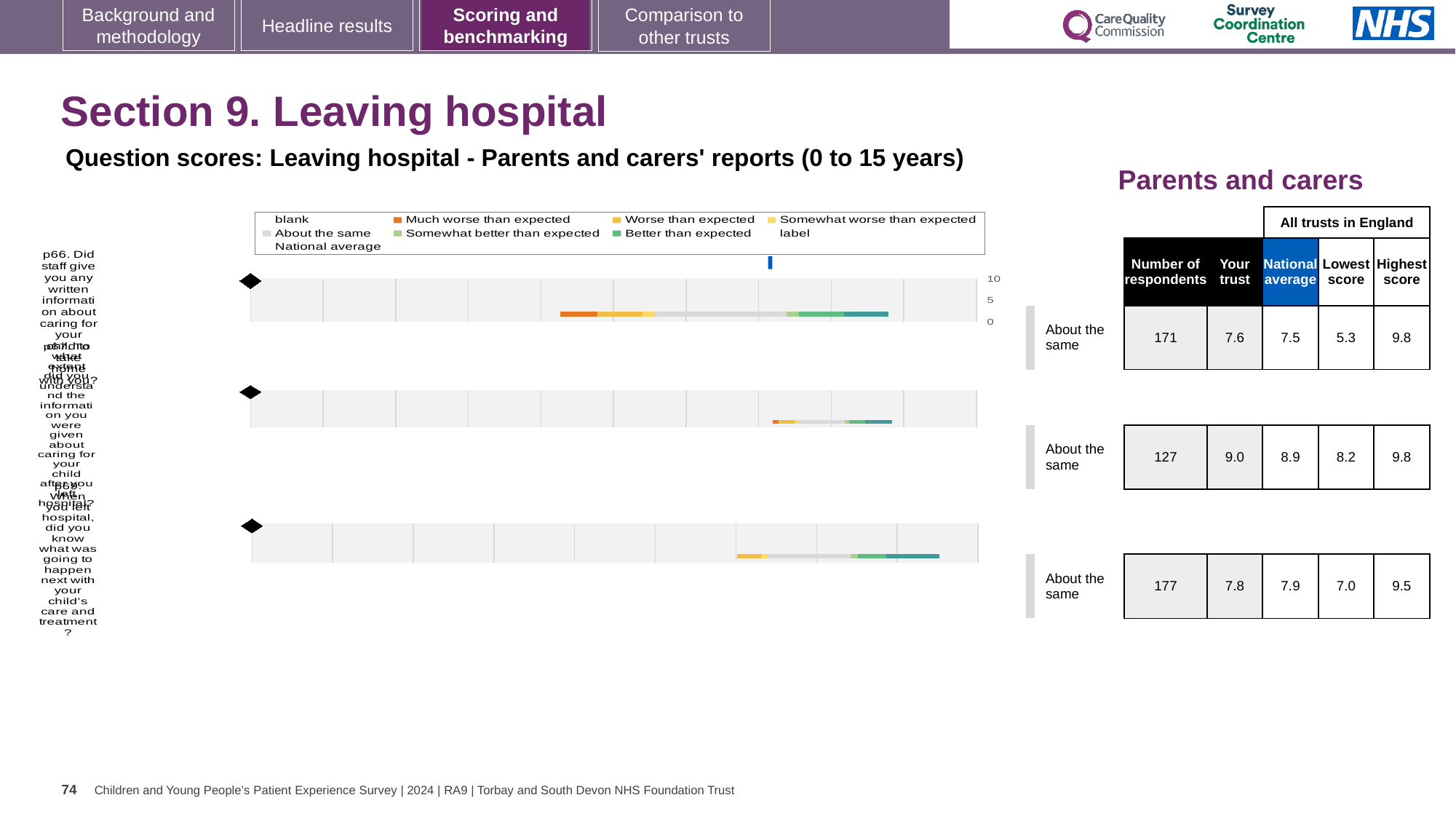
In the table beside the chart, what is the 'Your trust' score for the first row (p66, written information about caring for your child)? 7.6 What is the difference between the 'Your trust' score and the national average for the third row (p68)? 0.1 In the table beside the chart, what is the 'Your trust' score for the second row? 9.0 In the table beside the chart, what is the highest score for the third row (p68)? 9.5 In the table beside the chart, what is the national average for the first row (p66)? 7.5 How many entries does the chart legend list? 9 How many question rows (bars) are plotted in the chart? 3 What kind of chart is shown on the slide? bar chart Which row in the table has the lowest 'Lowest score' value? the first row (5.3) What is the highest tick value shown on the chart's axis? 10 Which of the three rows in the table has the highest 'Your trust' score? the second row (9.0) In the table beside the chart, how many respondents are listed for the second row? 127